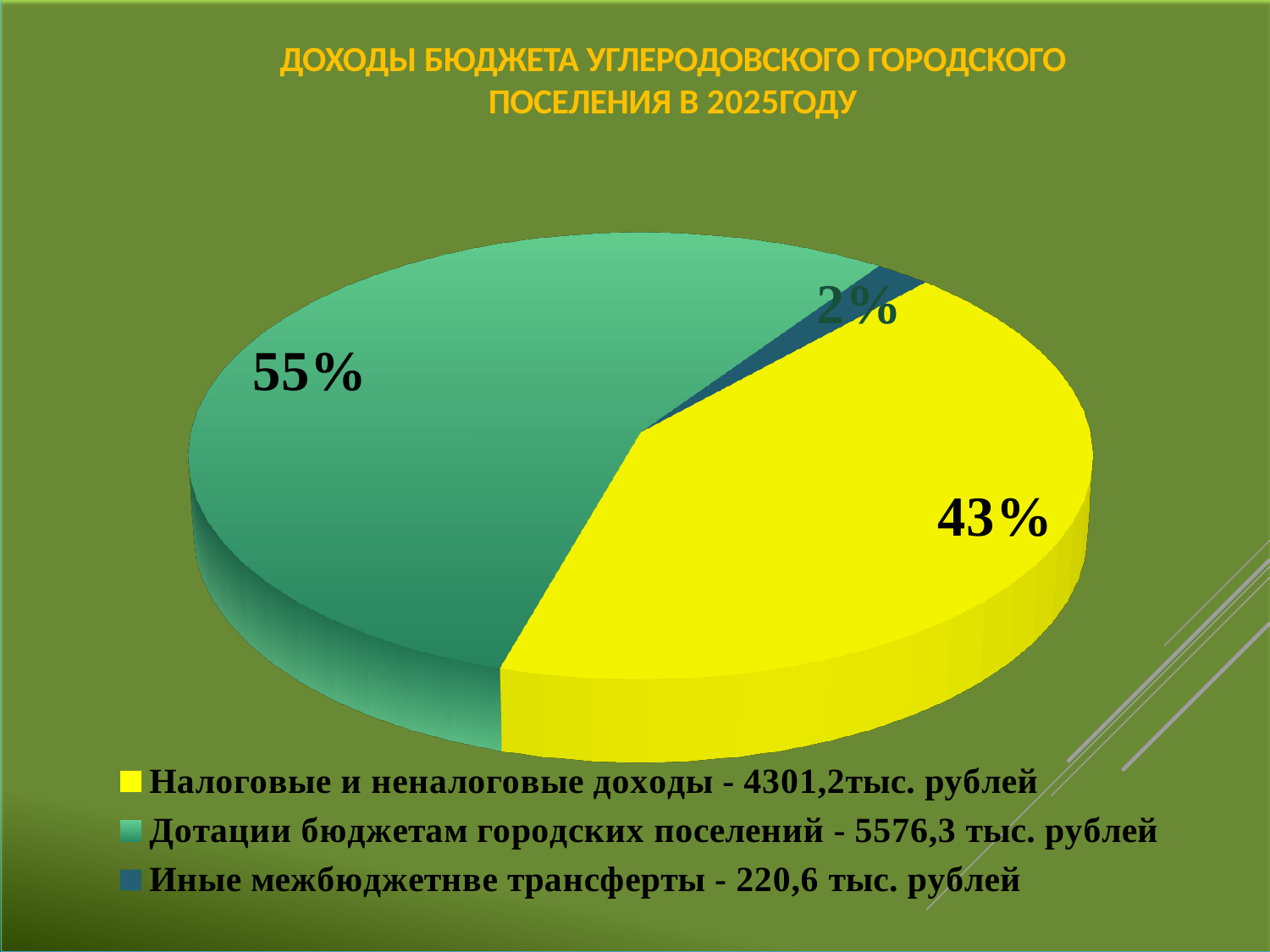
According to the legend, what amount in thousand rubles is given for Налоговые и неналоговые доходы? 4301,2 тыс. рублей What colour is the slice for Налоговые и неналоговые доходы? Yellow What share of the pie does the slice for Дотации бюджетам городских поселений represent? 55% What type of chart is shown on the slide? Pie chart Which category has the smallest slice of the pie? Иные межбюджетнве трансферты What share of the pie does the slice for Иные межбюджетнве трансферты represent? 2% Which is larger: the share for Налоговые и неналоговые доходы or the share for Дотации бюджетам городских поселений? Дотации бюджетам городских поселений What share of the pie does the slice for Налоговые и неналоговые доходы represent? 43% According to the legend, what amount in thousand rubles is given for Иные межбюджетнве трансферты? 220,6 тыс. рублей What is the difference in percentage points between the 55% slice and the 43% slice? 12 How many slices does the pie chart have? 3 Which category has the largest slice of the pie? Дотации бюджетам городских поселений